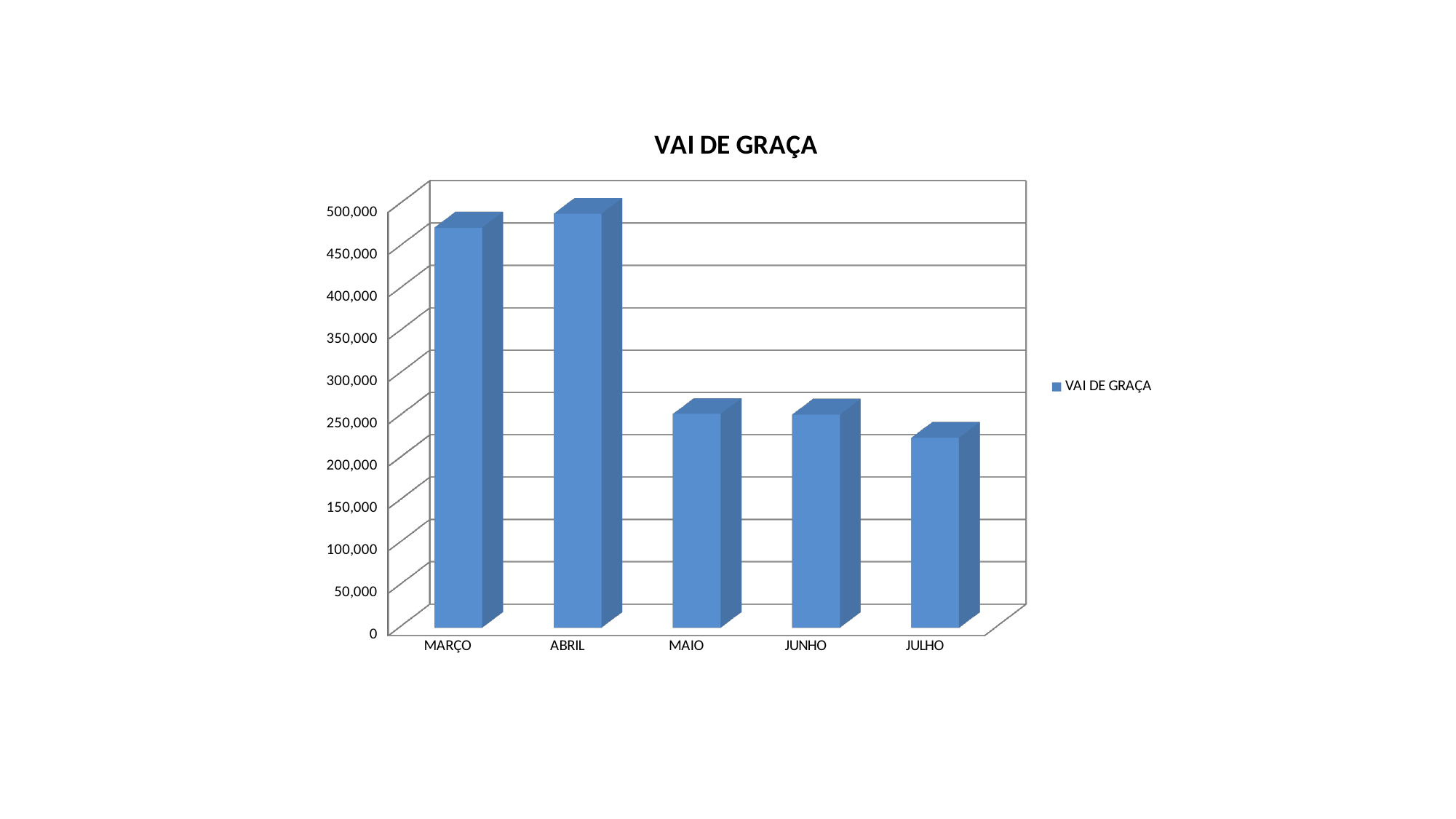
Is the value for JULHO greater or less than 300,000? less Which is larger, the value for MARÇO or the value for MAIO? MARÇO From ABRIL to JULHO, do the values rise or fall? fall Which month has the highest bar? ABRIL How many categories are shown on the x axis of the chart? 5 Is the value for MARÇO greater or less than 400,000? greater Which month has the lowest bar? JULHO How many series does the legend list? 1 What kind of chart is shown on the slide? bar chart Is the value for JUNHO greater or less than 200,000? greater What is the title of the chart? VAI DE GRAÇA